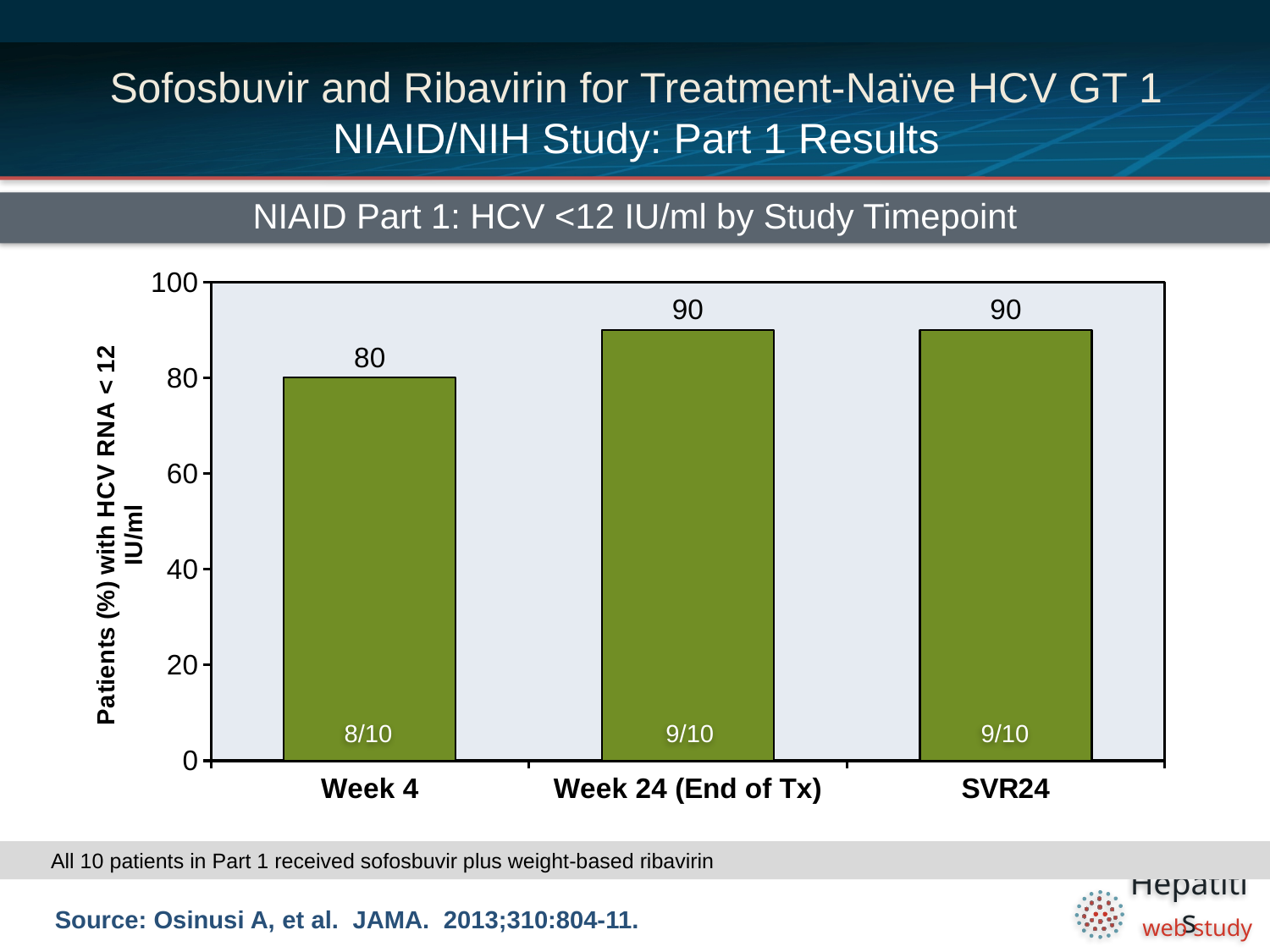
What is the value for Week 4? 80 Do the values rise or fall from Week 4 to Week 24 (End of Tx)? rise Which is larger, the value for Week 4 or the value for SVR24? SVR24 What is the value for SVR24? 90 What is the difference between the values for Week 24 (End of Tx) and Week 4? 10 What is the title of the chart? NIAID Part 1: HCV <12 IU/ml by Study Timepoint What fraction of patients is printed inside the Week 4 bar? 8/10 Is the value for Week 4 greater or less than 60? greater How many categories are shown on the x axis? 3 What kind of chart is shown? bar chart What is the value for Week 24 (End of Tx)? 90 Which category has the lowest value? Week 4